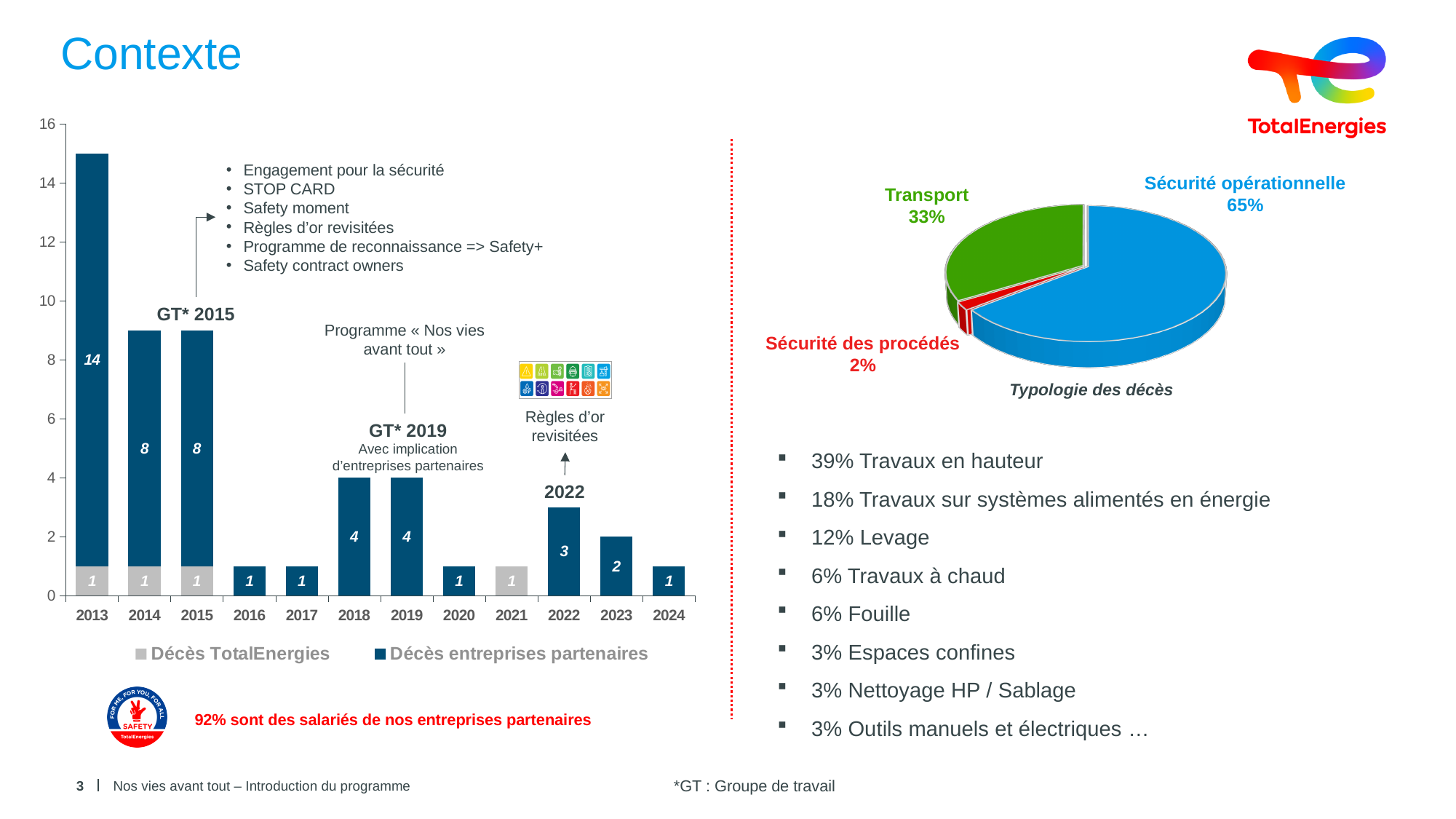
In the bar chart on the left, which is larger: the Décès entreprises partenaires value for 2019 or for 2022? 2019 In the bar chart on the left, what is the value for Décès entreprises partenaires in 2013? 14 In the bar chart on the left, what is the total of the stacked bar for 2014? 9 In the bar chart on the left, how many series does the legend list? 2 What kind of chart is the chart titled Typologie des décès? Pie chart In the bar chart on the left, which year has the highest total? 2013 In the bar chart on the left, how many years are shown on the x axis? 12 In the pie chart Typologie des décès, which category has the smallest share? Sécurité des procédés In the bar chart on the left, what is the value for Décès entreprises partenaires in 2022? 3 In the bar chart on the left, what is the difference between the Décès entreprises partenaires values for 2018 and 2023? 2 In the pie chart Typologie des décès, what share does Transport have? 33% In the bar chart on the left, what is the total of the stacked bar for 2013? 15